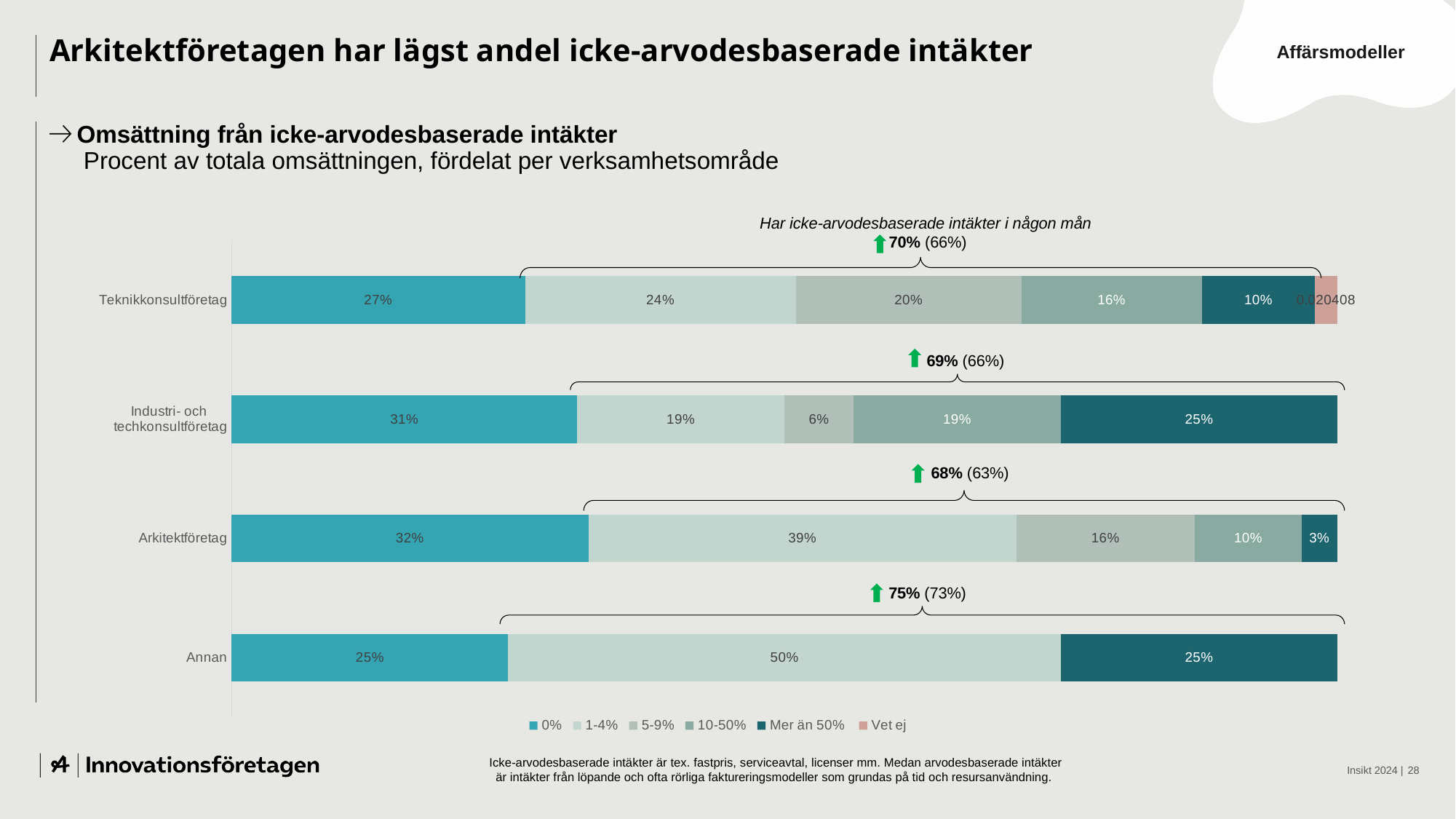
What is the difference between the '1-4%' segment for Arkitektföretag and the '1-4%' segment for Teknikkonsultföretag? 15% What is the value of the 'Mer än 50%' segment for Industri- och techkonsultföretag? 25% How many categories (verksamhetsområden) are plotted on the chart? 4 Which category has the lowest value for the '0%' segment? Annan What share of Annan companies has non-fee-based revenue to some extent (Har icke-arvodesbaserade intäkter i någon mån), according to the annotation above the bar? 75% What is the value of the '1-4%' segment for Annan? 50% How many series does the legend list? 6 Which category has the highest value for the '1-4%' segment? Annan What is the value of the '0%' segment for Arkitektföretag? 32% What is the value of the '5-9%' segment for Teknikkonsultföretag? 20% What kind of chart is shown on the slide? Stacked bar chart Which is larger: the '10-50%' segment for Industri- och techkonsultföretag or the '10-50%' segment for Arkitektföretag? Industri- och techkonsultföretag